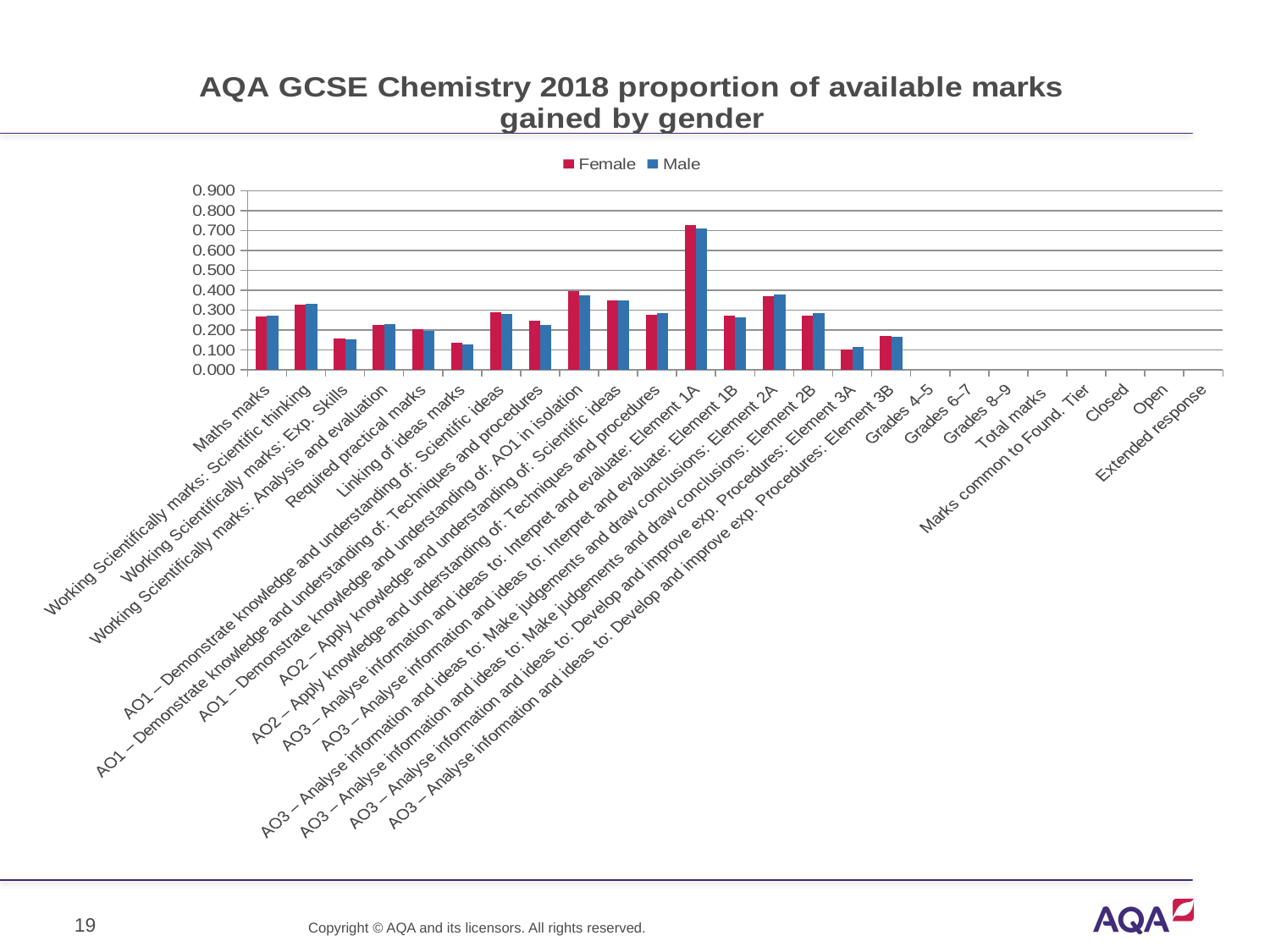
Is the Female value for Maths marks greater or less than 0.300? less Which category has the highest Male value? AO3 – Analyse information and ideas to: Interpret and evaluate: Element 1A Among the categories with plotted bars, which has the lowest Female value? AO3 – Analyse information and ideas to: Develop and improve exp. Procedures: Element 3A How many series does the legend list? 2 Is the Female value for AO1 – Demonstrate knowledge and understanding of: AO1 in isolation greater or less than 0.300? greater What kind of chart is shown on the slide? bar chart Which colour represents the Male series in the chart? blue Which is larger for Male: Working Scientifically marks: Scientific thinking or Working Scientifically marks: Exp. Skills? Working Scientifically marks: Scientific thinking Is the Female value for AO3 – Interpret and evaluate: Element 1A greater or less than 0.600? greater Which is larger for Female: AO3 – Interpret and evaluate: Element 1A or AO3 – Interpret and evaluate: Element 1B? Element 1A Which category has the highest Female value? AO3 – Analyse information and ideas to: Interpret and evaluate: Element 1A